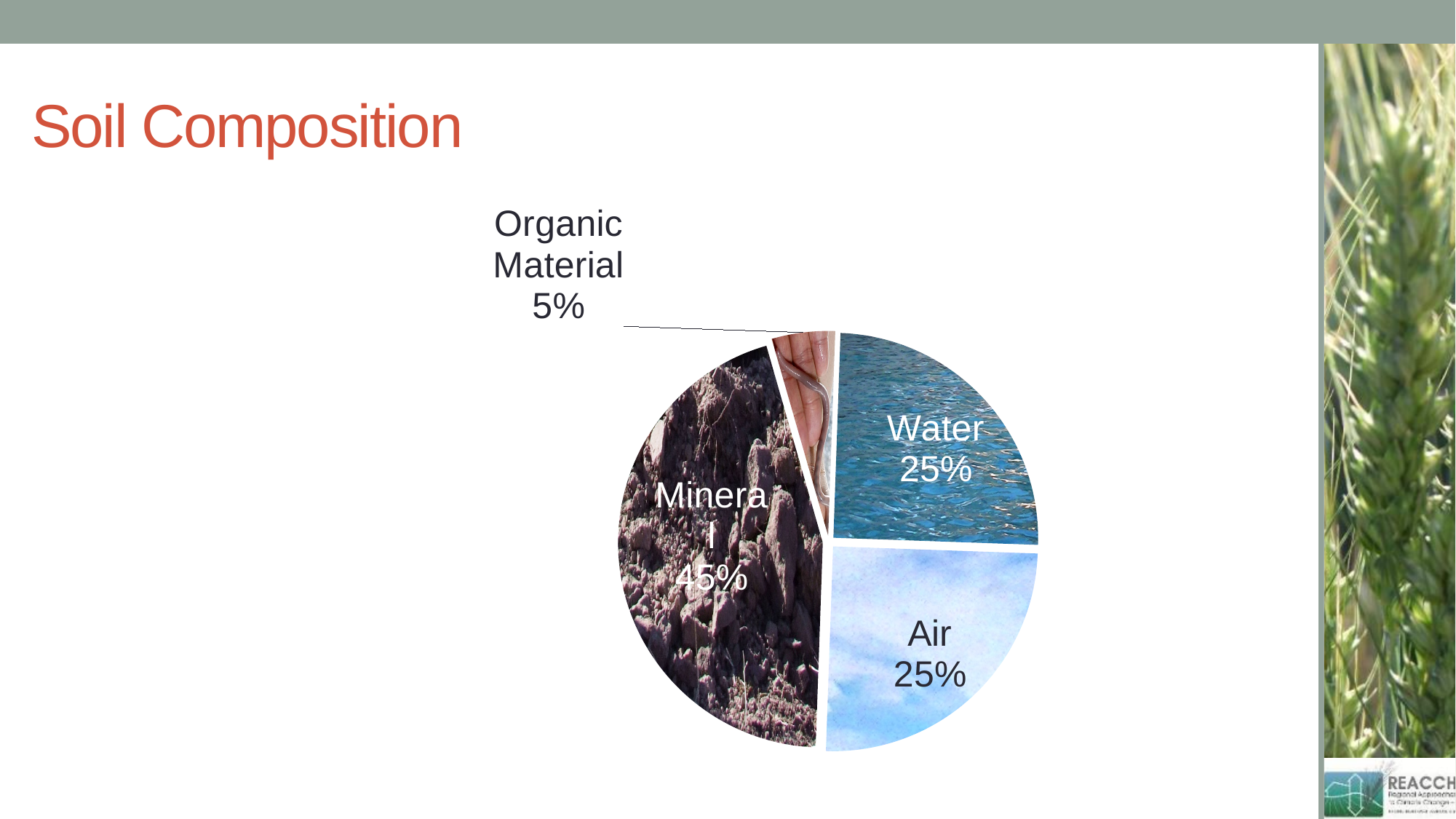
What percentage of soil composition is Mineral? 45% What percentage of soil composition is Organic Material? 5% What kind of chart is shown on the slide? pie chart What is the difference in percentage points between Mineral and Water? 20 What percentage of soil composition is Air? 25% What is the difference in percentage points between Air and Organic Material? 20 Which component makes up the largest share of the pie? Mineral How many slices does the pie chart have? 4 What is the title of the slide containing the pie chart? Soil Composition What percentage of soil composition is Water? 25% Which is larger, the Mineral share or the Air share? Mineral Which component makes up the smallest share of the pie? Organic Material